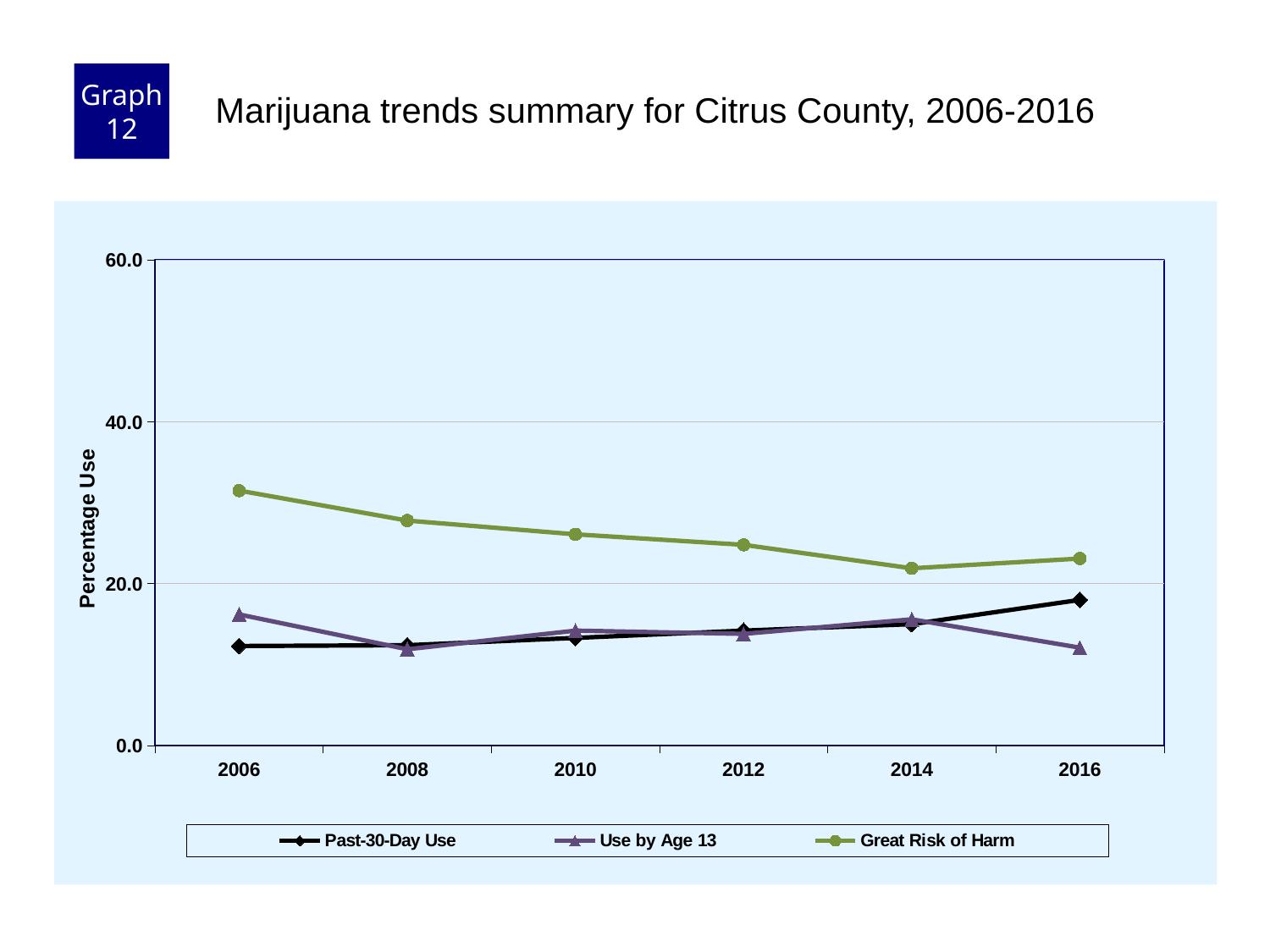
Which series has the highest value in 2006? Great Risk of Harm Is the value for Great Risk of Harm in 2006 greater or less than 20.0? greater Is the value for Past-30-Day Use in 2016 greater or less than 20.0? less Is the value for Great Risk of Harm in 2006 greater or less than 40.0? less How many series does the legend list? 3 In which year is the Great Risk of Harm value highest? 2006 What is the label on the y axis? Percentage Use What kind of chart is shown on the slide? Line chart How many years are plotted along the x axis? 6 Does the Great Risk of Harm line rise or fall overall from 2006 to 2016? Fall In 2016, which is larger: Past-30-Day Use or Use by Age 13? Past-30-Day Use Does the Past-30-Day Use line rise or fall overall from 2006 to 2016? Rise